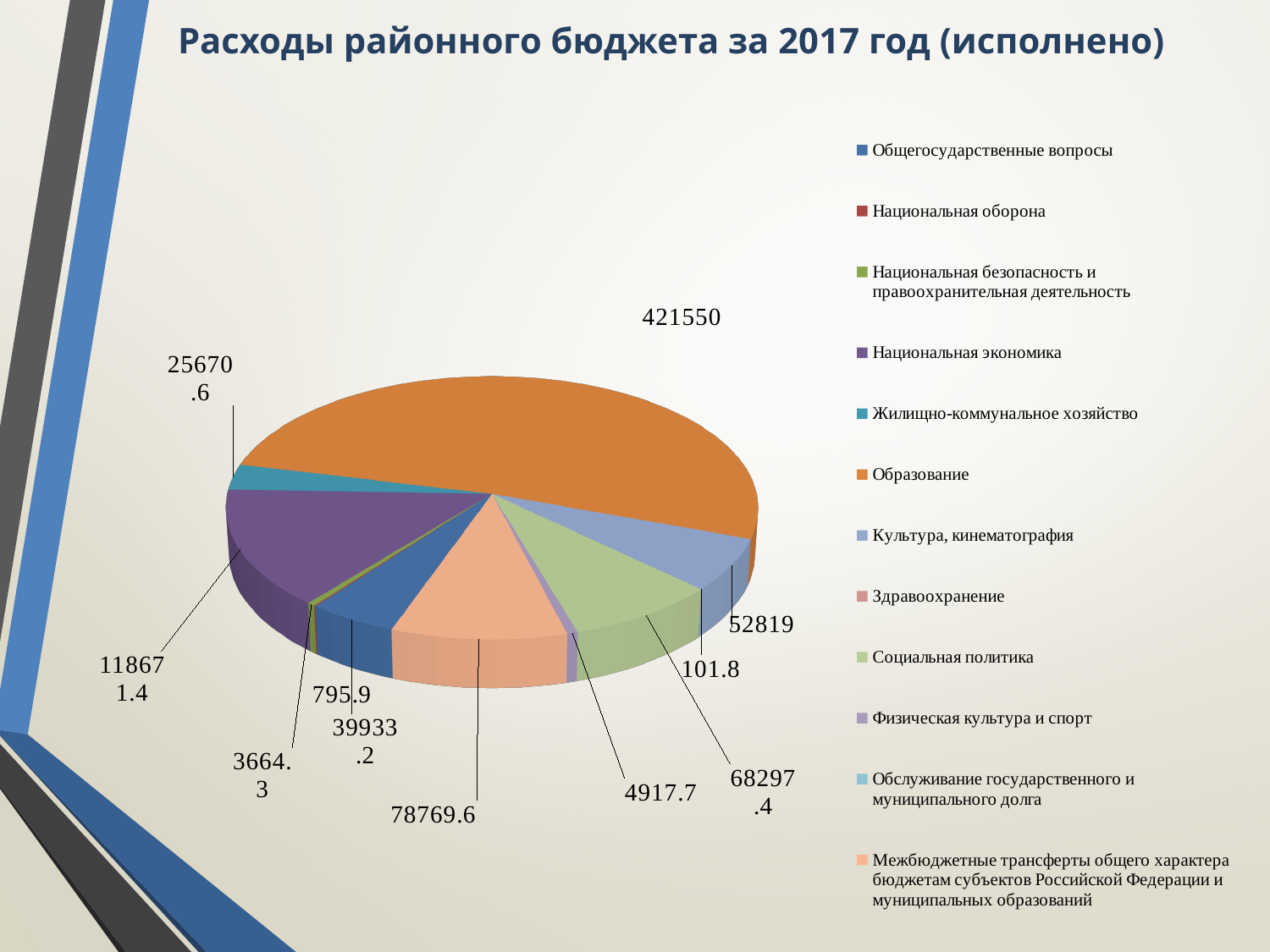
What is the value shown for Культура, кинематография? 52819 What is the difference between the value for Образование and the value for Национальная экономика? 302878.6 What kind of chart is shown on the slide? Pie chart What is the title of the chart? Расходы районного бюджета за 2017 год (исполнено) Which category has the largest slice of the pie? Образование What is the value shown for Социальная политика? 68297.4 What is the value shown for Национальная экономика? 118671.4 What is the value shown for Жилищно-коммунальное хозяйство? 25670.6 Which is larger, the value for Национальная экономика or the value for Общегосударственные вопросы? Национальная экономика How many categories does the legend list? 12 What is the value shown for Межбюджетные трансферты общего характера бюджетам субъектов Российской Федерации и муниципальных образований? 78769.6 What is the value shown for Образование? 421550